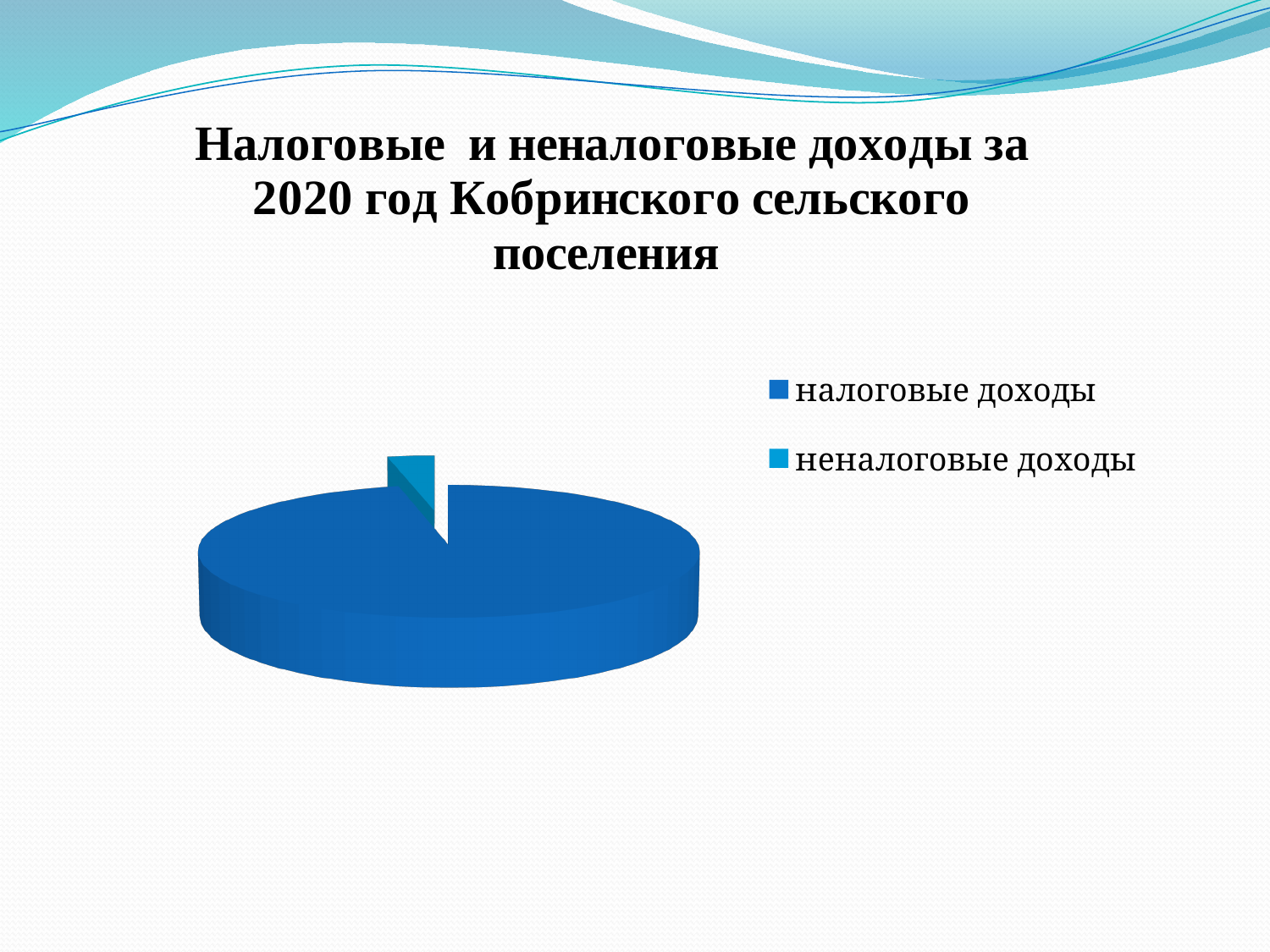
Which category has the largest slice of the pie chart? налоговые доходы Which category has the smallest slice of the pie chart? неналоговые доходы Which is larger in the pie chart: налоговые доходы or неналоговые доходы? налоговые доходы What is the title of the chart on the slide? Налоговые и неналоговые доходы за 2020 год Кобринского сельского поселения Which legend entry is shown in the lighter blue colour? неналоговые доходы How many entries does the legend of the pie chart list? 2 How many slices does the pie chart have? 2 What kind of chart is shown on the slide? pie chart